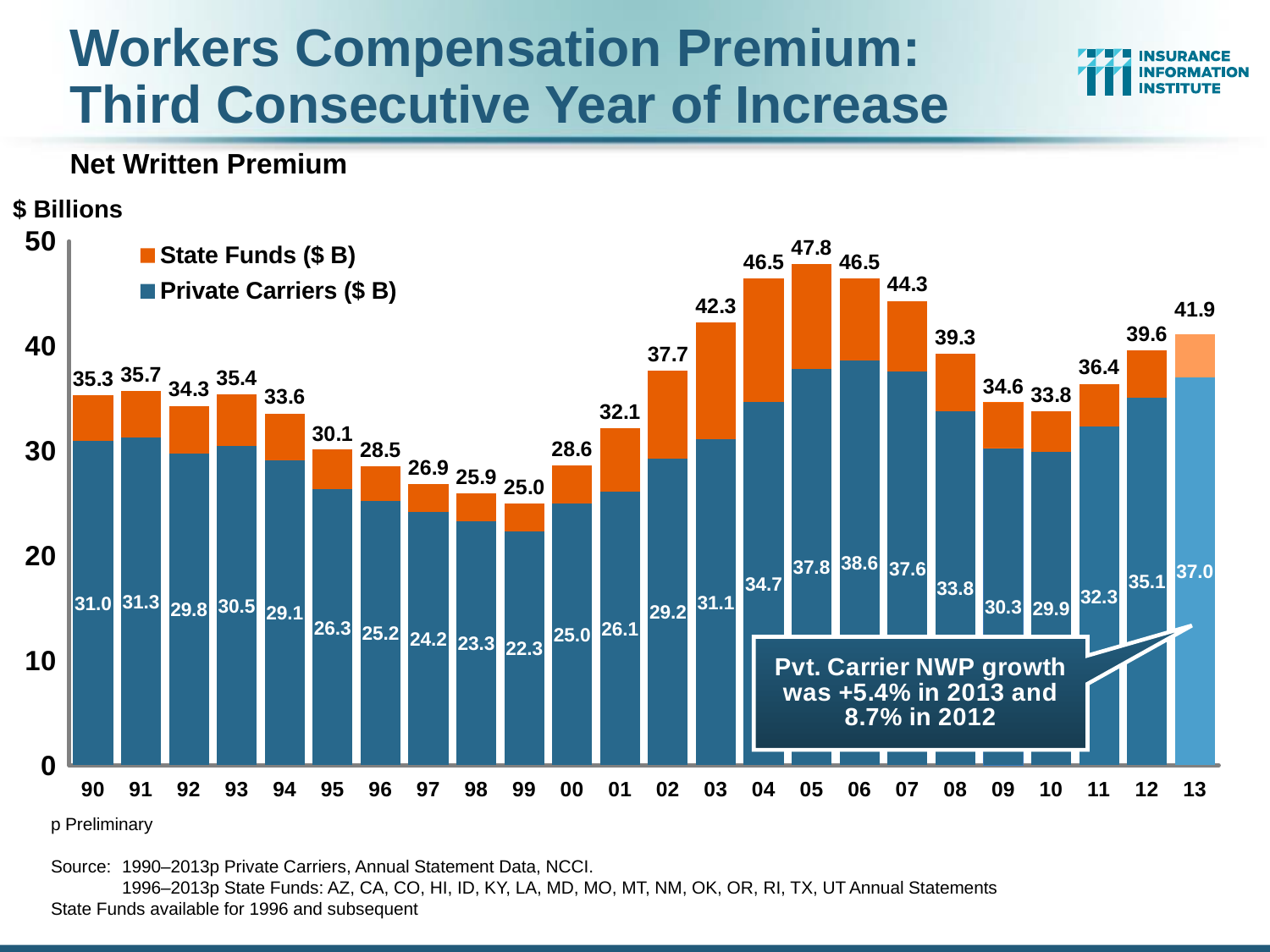
Which year had the highest total net written premium? 05 How many years are shown on the x axis of the chart? 24 Which year had the lowest total net written premium? 99 Did the total net written premium rise or fall from 2010 to 2013? Rise What kind of chart is shown on the slide? Stacked bar chart By how much did the total net written premium increase from 2012 to 2013? 2.3 Which year had the highest Private Carriers net written premium? 06 What was the total net written premium in 2005? 47.8 What was the Private Carriers net written premium in 2013? 37.0 How many series does the legend list? 2 Which year had a higher total net written premium, 2003 or 2008? 03 What was the State Funds portion of net written premium in 2013 (total minus Private Carriers)? 4.9